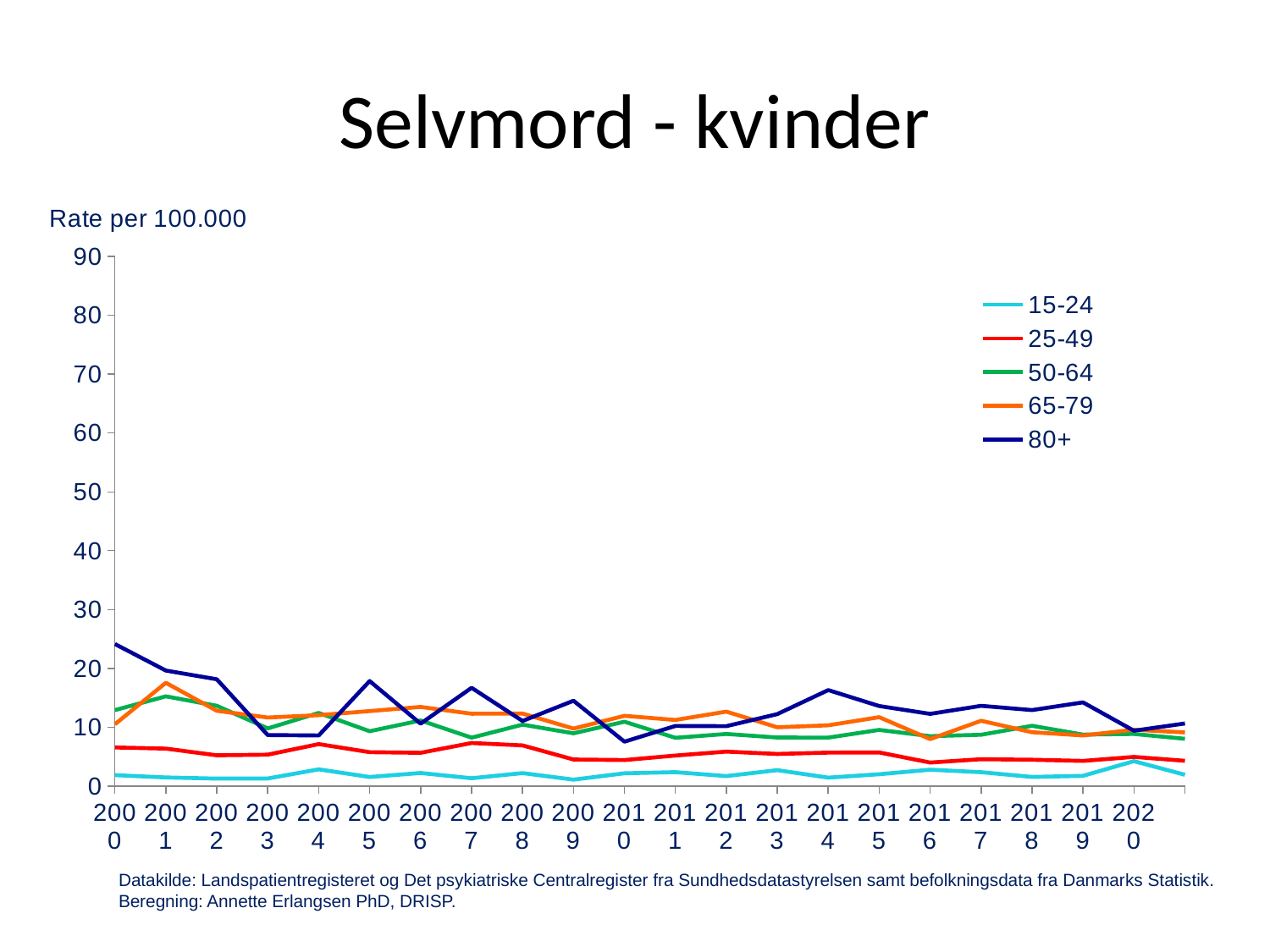
Does the 80+ series rise or fall from 2000 to 2003? fall Is the value for the 15-24 series in 2000 greater or less than 10? less How many series does the legend list? 5 Is the value for the 25-49 series in 2010 greater or less than 10? less Which series has the highest value in 2000? 80+ Which series has the lowest value in 2000? 15-24 Is the value for the 80+ series in 2000 greater or less than 20? greater What is the title of the chart? Selvmord - kvinder What is the label on the y axis? Rate per 100.000 How many years are shown along the x axis? 21 What kind of chart is shown on the slide? line chart In 2000, which is larger: the value for 80+ or the value for 25-49? 80+